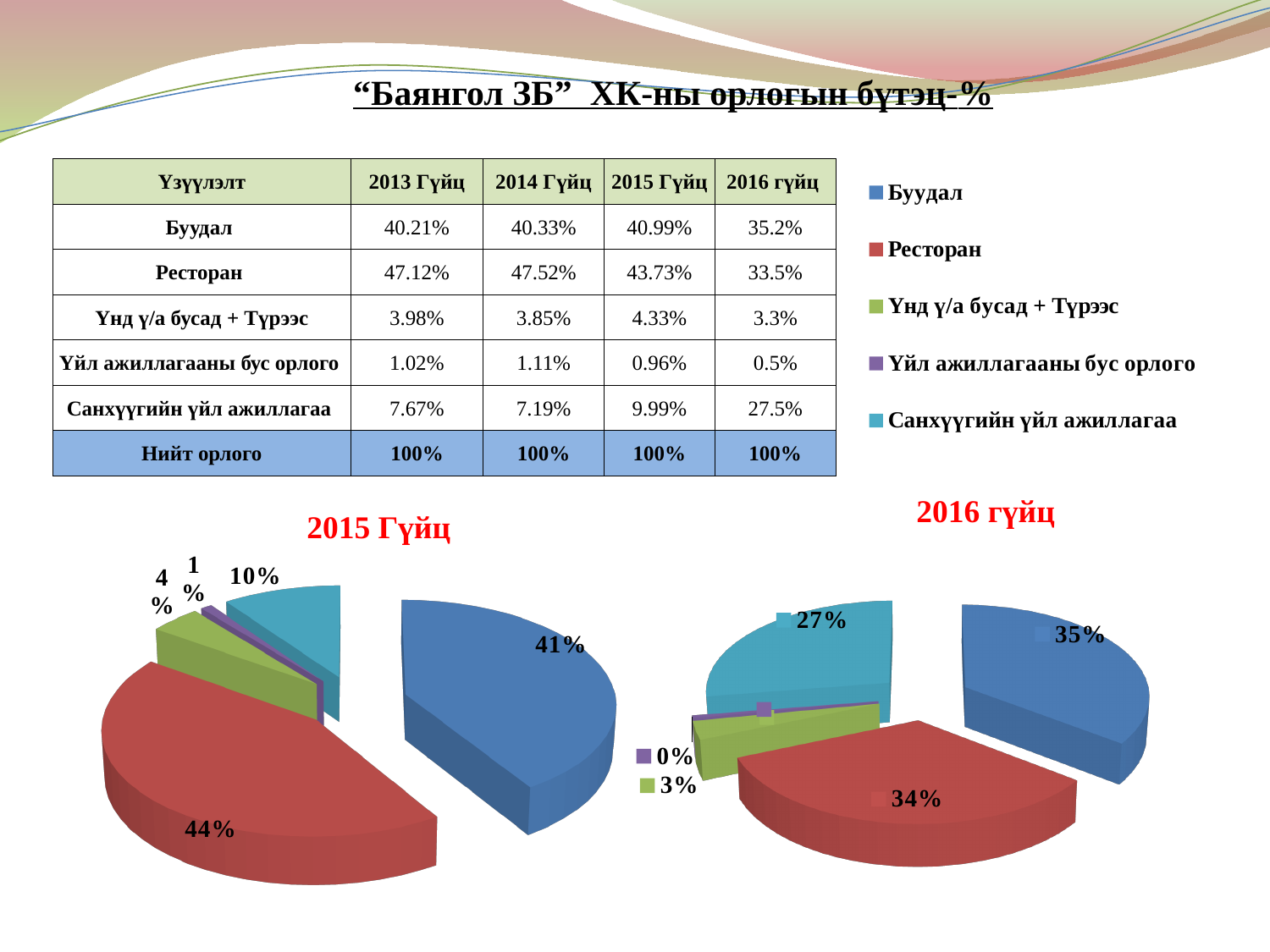
In the "2015 Гүйц" pie chart, what share is labelled for the Буудал slice? 41% In the "2016 гүйц" pie chart, what share is labelled for the Буудал slice? 35% In the "2015 Гүйц" pie chart, what is the difference between the Ресторан slice and the Буудал slice? 3% In the "2016 гүйц" pie chart, what share is labelled for the Санхүүгийн үйл ажиллагаа slice? 27% In the "2016 гүйц" pie chart, which category has the smallest slice? Үйл ажиллагааны бус орлого In the "2015 Гүйц" pie chart, which category has the largest slice? Ресторан How many categories does the legend list for the pie charts? 5 In the "2016 гүйц" pie chart, which is larger: the Ресторан slice or the Санхүүгийн үйл ажиллагаа slice? Ресторан In the "2016 гүйц" pie chart, what share is labelled for the Үнд ү/а бусад + Түрээс slice? 3% What kind of chart is the "2015 Гүйц" chart? pie chart In the "2015 Гүйц" pie chart, what share is labelled for the Ресторан slice? 44% In the "2015 Гүйц" pie chart, what share is labelled for the Санхүүгийн үйл ажиллагаа slice? 10%